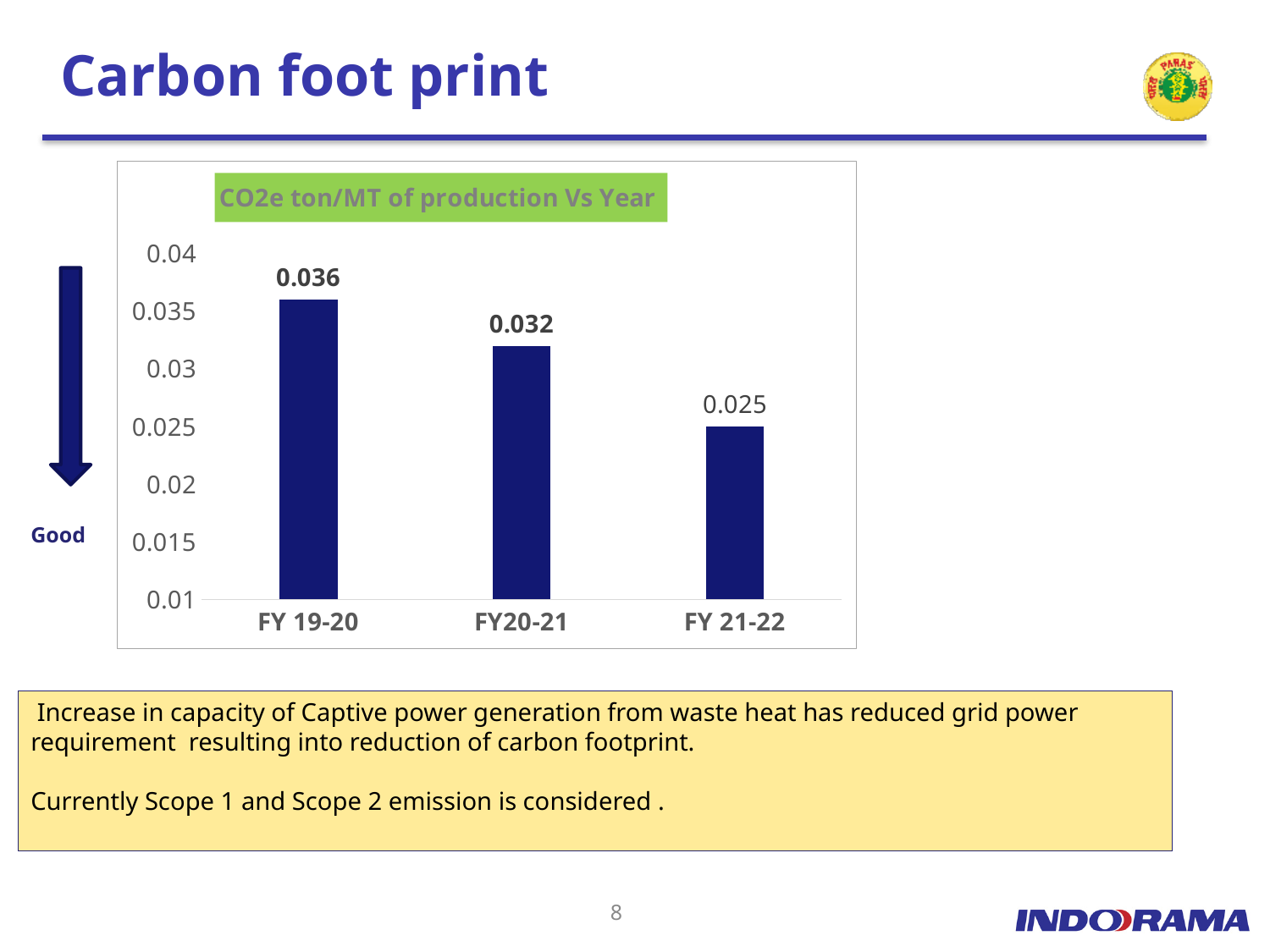
Which year has the highest CO2e ton/MT of production? FY 19-20 What kind of chart is shown on the slide? bar chart Do the values rise or fall from FY 19-20 to FY 21-22? fall How many years are shown on the chart? 3 Which year has the lowest CO2e ton/MT of production? FY 21-22 What is the difference in CO2e ton/MT of production between FY 19-20 and FY20-21? 0.004 Is the value for FY 21-22 greater or less than 0.03? less What is the CO2e ton/MT of production value for FY20-21? 0.032 What is the CO2e ton/MT of production value for FY 21-22? 0.025 What is the difference in CO2e ton/MT of production between FY 19-20 and FY 21-22? 0.011 Which is larger, the value for FY20-21 or the value for FY 21-22? FY20-21 What is the CO2e ton/MT of production value for FY 19-20? 0.036